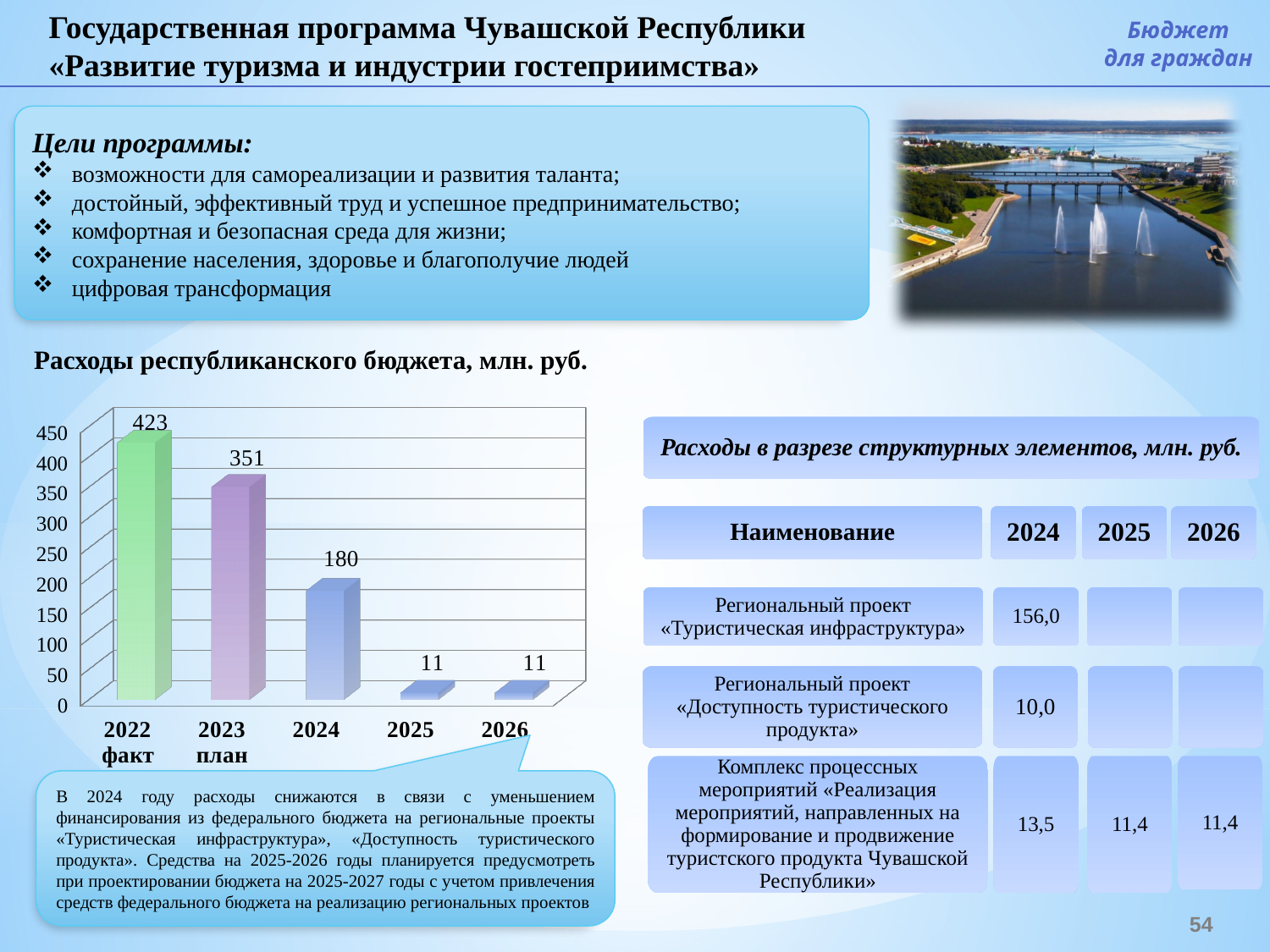
What is the value for 2024 in the chart? 180 What is the difference between the values for 2023 план and 2024? 171 What is the difference between the values for 2022 факт and 2023 план? 72 What is the value for 2025 in the chart? 11 Which year has the highest value in the chart? 2022 факт Do the values in the chart rise or fall from 2022 to 2025? fall Which is larger, the value for 2024 or the value for 2025? 2024 Is the value for 2024 greater or less than 200? less What is the value for 2023 план in the chart? 351 What is the value for 2022 факт in the chart? 423 What kind of chart is shown on the slide? bar chart How many categories are shown on the x axis of the chart? 5